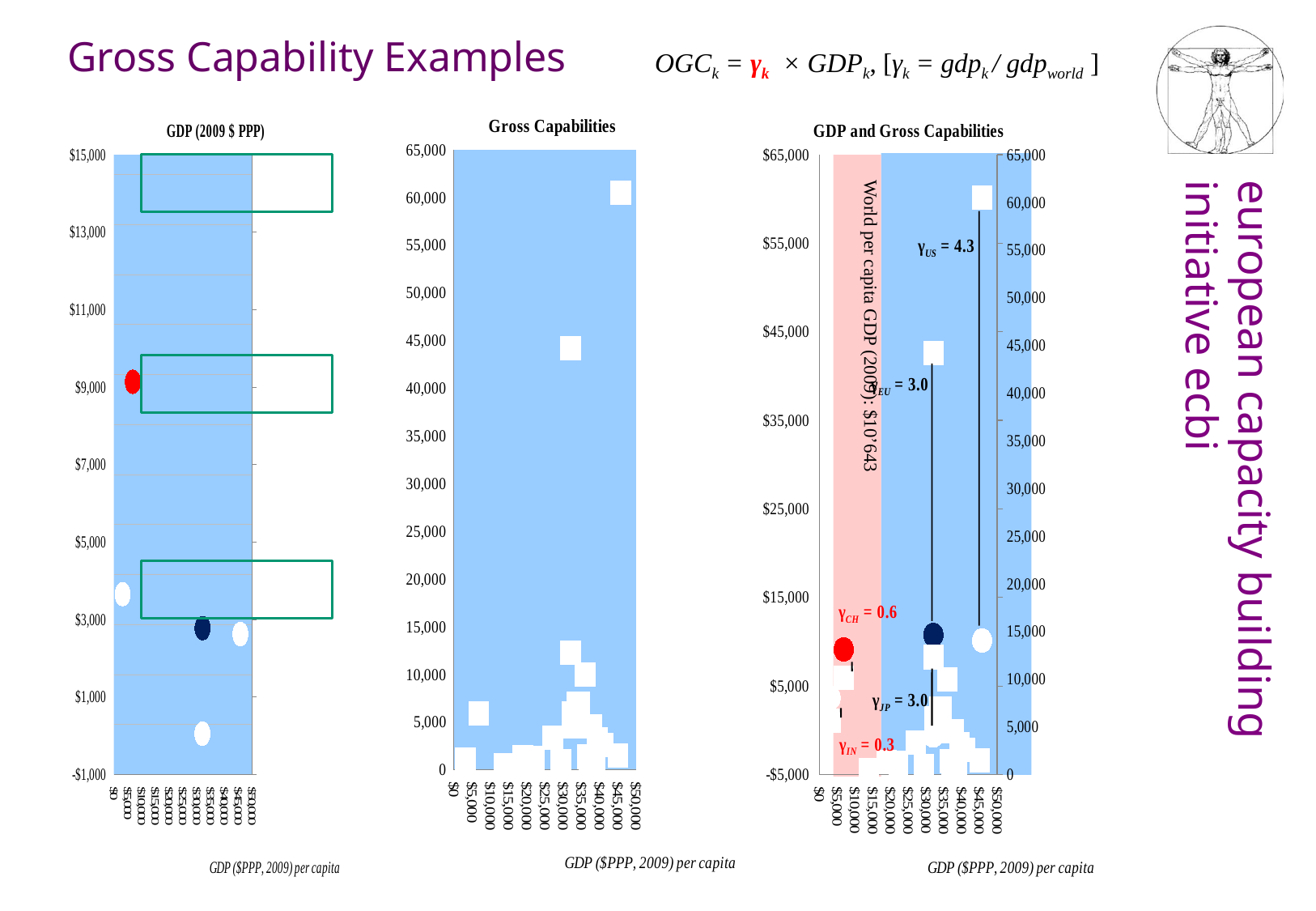
In the right chart, 'GDP and Gross Capabilities', which country has the highest γ value labelled? US In the right chart, 'GDP and Gross Capabilities', what is the value of γ_CH shown? 0.6 In the right chart, 'GDP and Gross Capabilities', is the value for the red point (CH) on the left axis greater or less than $15,000? less In the right chart, 'GDP and Gross Capabilities', what is the value of γ_IN shown? 0.3 In the right chart, 'GDP and Gross Capabilities', what world per capita GDP (2009) value is labelled? $10'643 In the right chart, 'GDP and Gross Capabilities', what is the value of γ_JP shown? 3.0 What is the title of the middle chart? Gross Capabilities How many charts are shown on the slide? 3 What is the title of the left chart? GDP (2009 $ PPP) In the right chart, 'GDP and Gross Capabilities', which country has the lowest γ value labelled? IN In the right chart, 'GDP and Gross Capabilities', what is the value of γ_US shown? 4.3 In the right chart, 'GDP and Gross Capabilities', what is the difference between γ_US and γ_EU? 1.3